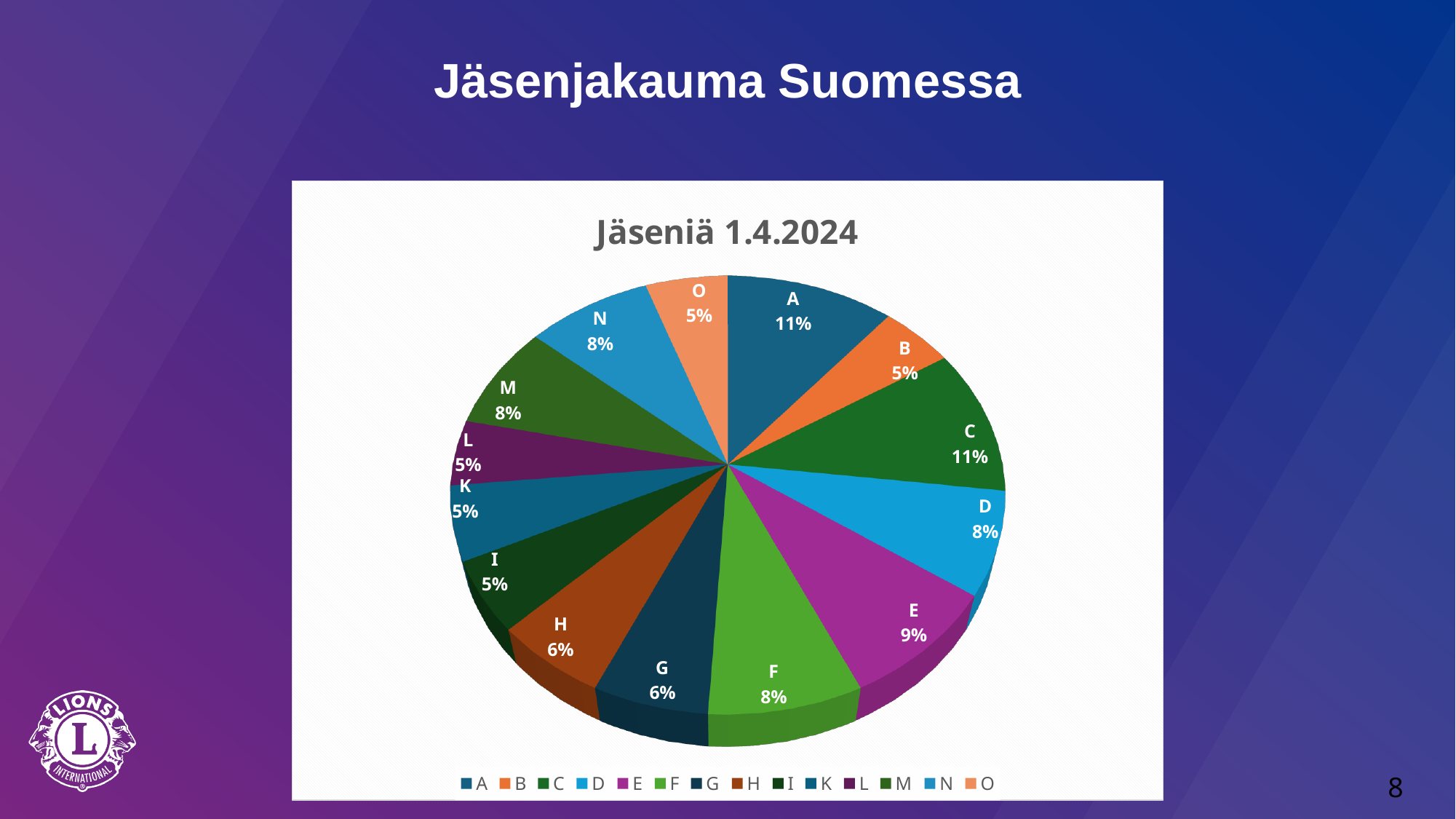
What is the value shown for category N? 8% What is the value shown for category H? 6% What kind of chart is shown on the slide? Pie chart What share of the pie does category E have? 9% What is the value shown for category O? 5% Which two categories share the largest slice of the pie? A and C What is the title of the chart? Jäseniä 1.4.2024 What share of the pie does category A have? 11% How many entries does the legend list? 14 How many categories does the pie chart have? 14 Which is larger, the share for E or the share for D? E What is the difference between the share for C and the share for B? 6%